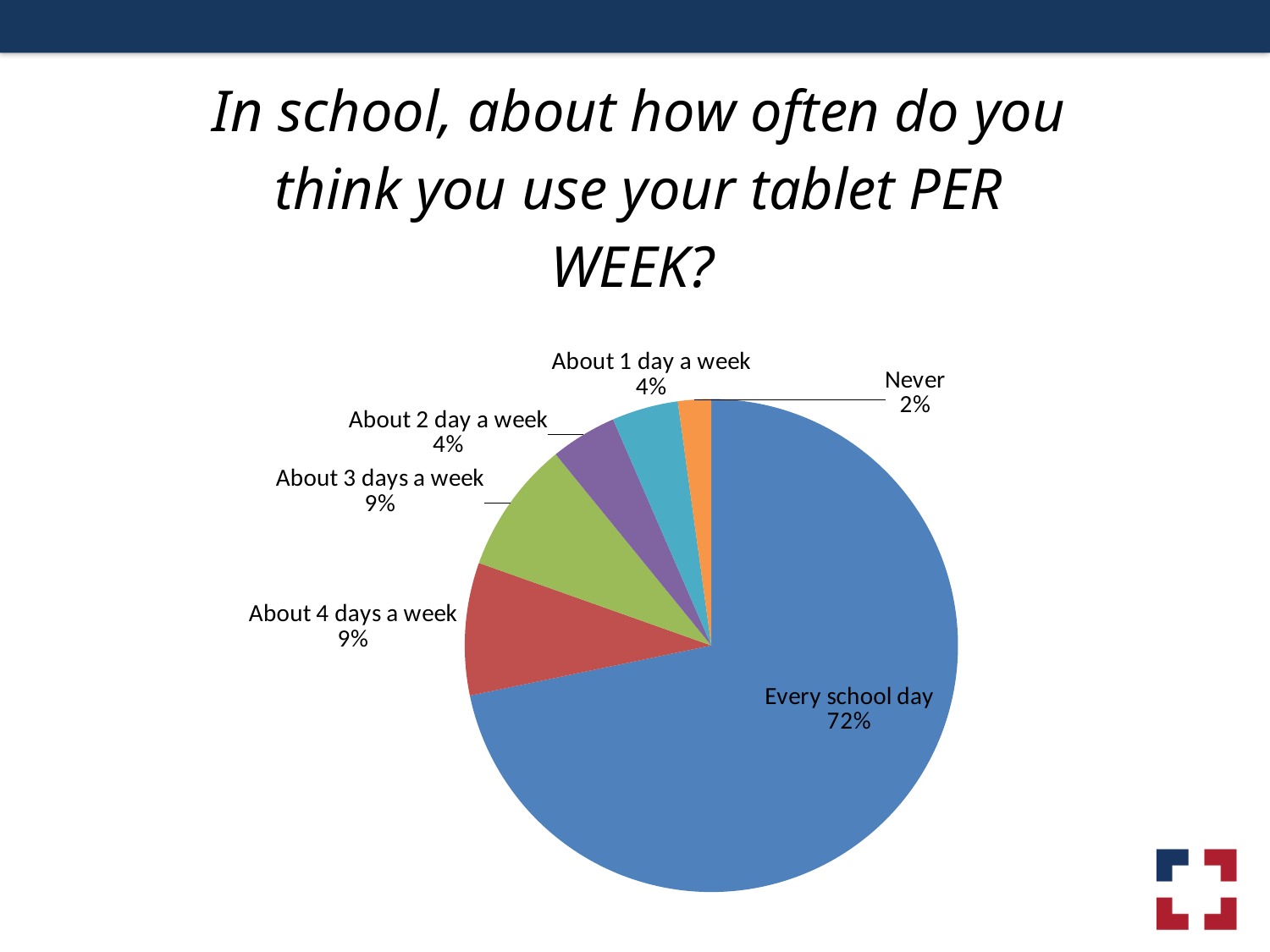
What type of chart is shown on the slide? pie chart What percentage of respondents use their tablet every school day? 72% Which category has the smallest share of the pie? Never Which is larger: the share for 'About 3 days a week' or the share for 'About 2 day a week'? About 3 days a week How many categories (slices) does the pie chart have? 6 Which category has the largest share of the pie? Every school day What is the difference in percentage points between 'Every school day' and 'About 4 days a week'? 63 What colour is the 'Every school day' slice? blue What percentage of respondents use their tablet about 3 days a week? 9% What percentage of respondents use their tablet about 1 day a week? 4% What percentage of respondents answered 'Never'? 2% What is the combined share of 'About 1 day a week' and 'About 2 day a week'? 8%